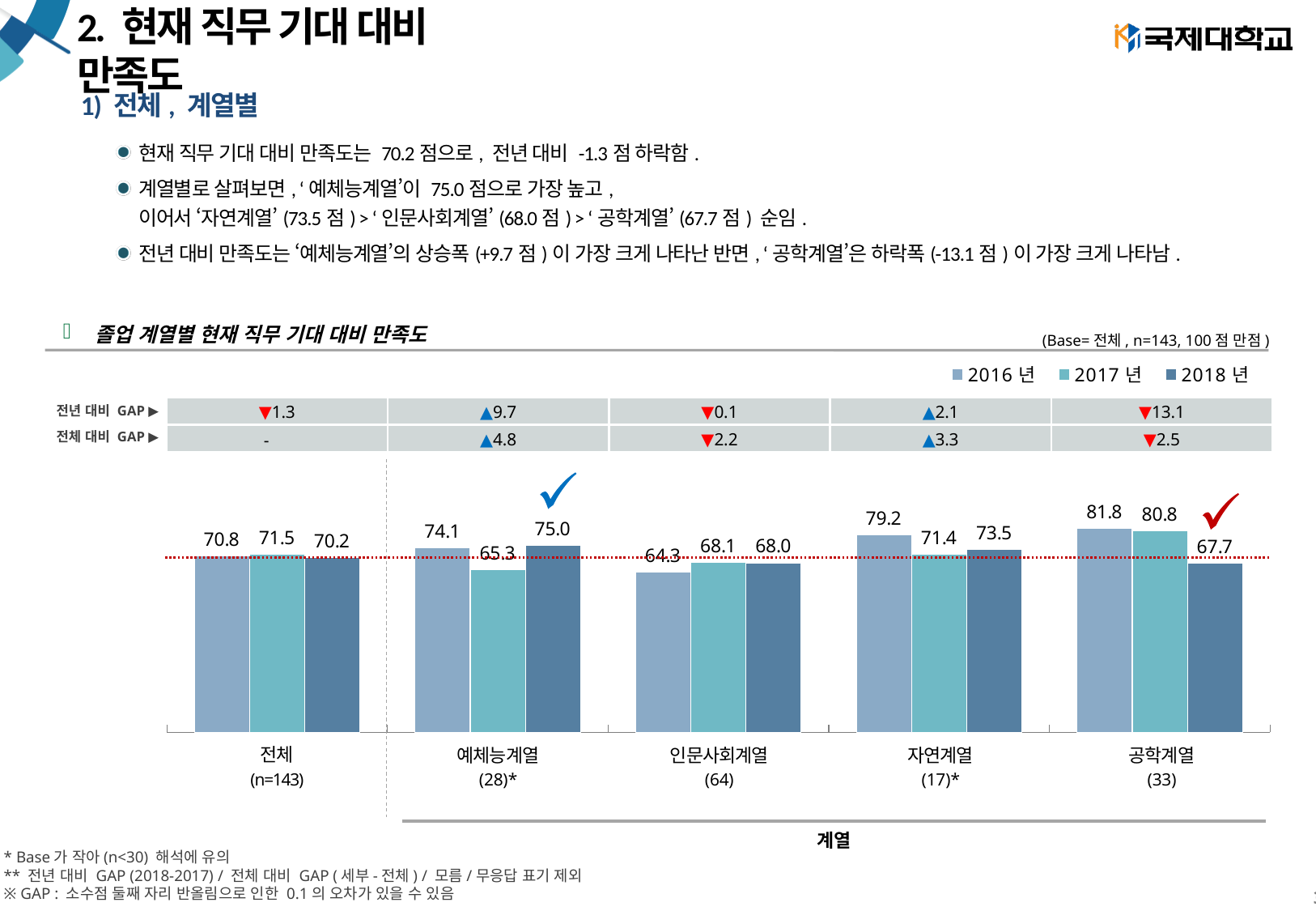
Which category has the highest 2018년 value? 예체능계열 What is the difference between the 2017년 and 2018년 values for 공학계열? 13.1 What is the title of the chart? 졸업 계열별 현재 직무 기대 대비 만족도 What is the 2018년 value for 예체능계열? 75.0 Which category has the lowest 2016년 value? 인문사회계열 How many series does the legend list? 3 What is the 2016년 value for 공학계열? 81.8 How does the 공학계열 value change from 2016년 to 2018년? falls What is the 2017년 value for 자연계열? 71.4 How many categories are shown on the x axis of the chart? 5 Which is larger for 예체능계열: the 2016년 value or the 2017년 value? 2016년 What type of chart is shown on the slide? bar chart